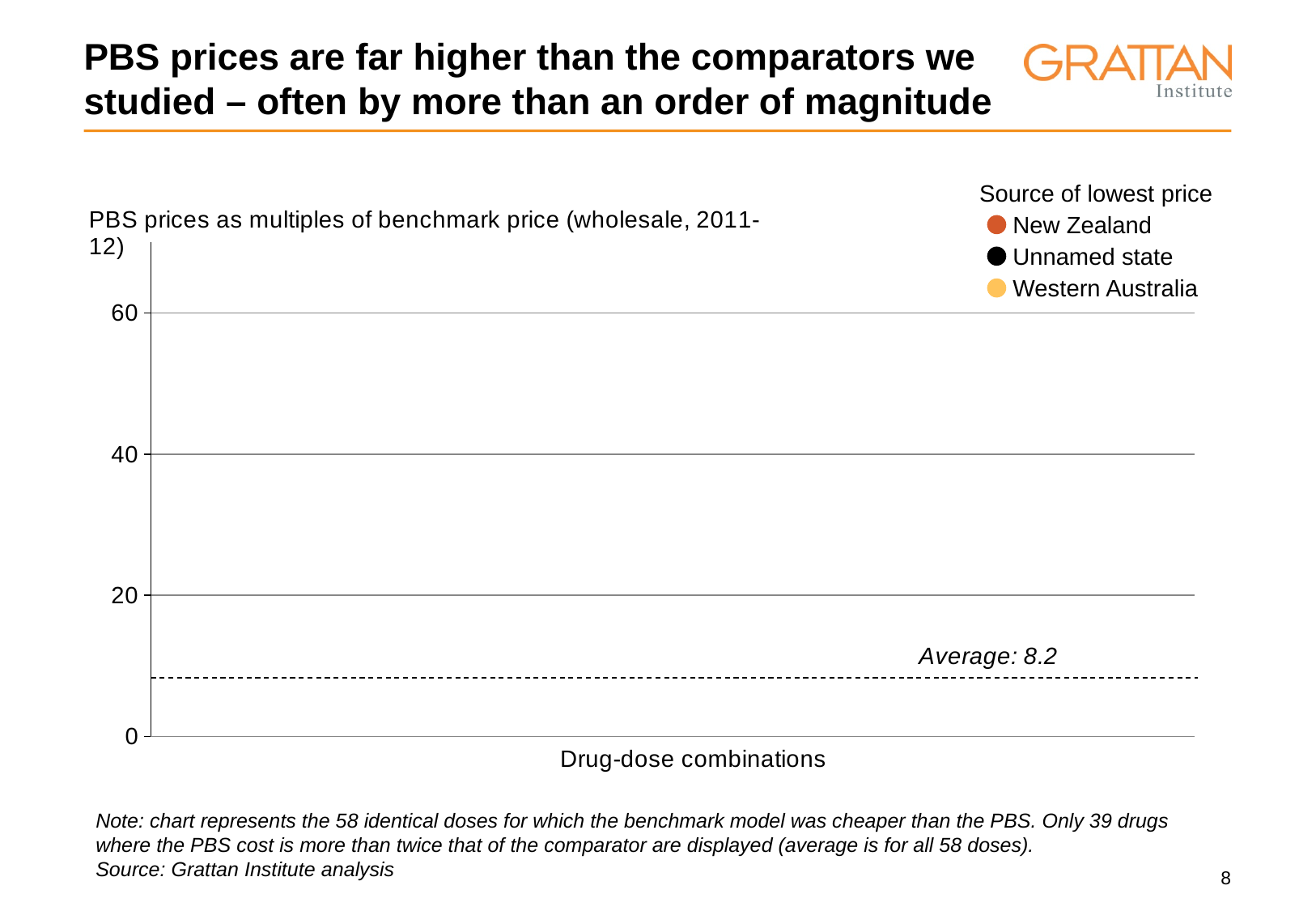
What is the highest value labelled on the y axis? 60 What is the title of the chart? PBS prices as multiples of benchmark price (wholesale, 2011-12) How many sources of lowest price does the legend list? 3 What is the label of the x axis? Drug-dose combinations Is the average value marked on the chart greater or less than 20? less What is the average value shown by the dashed line on the chart? 8.2